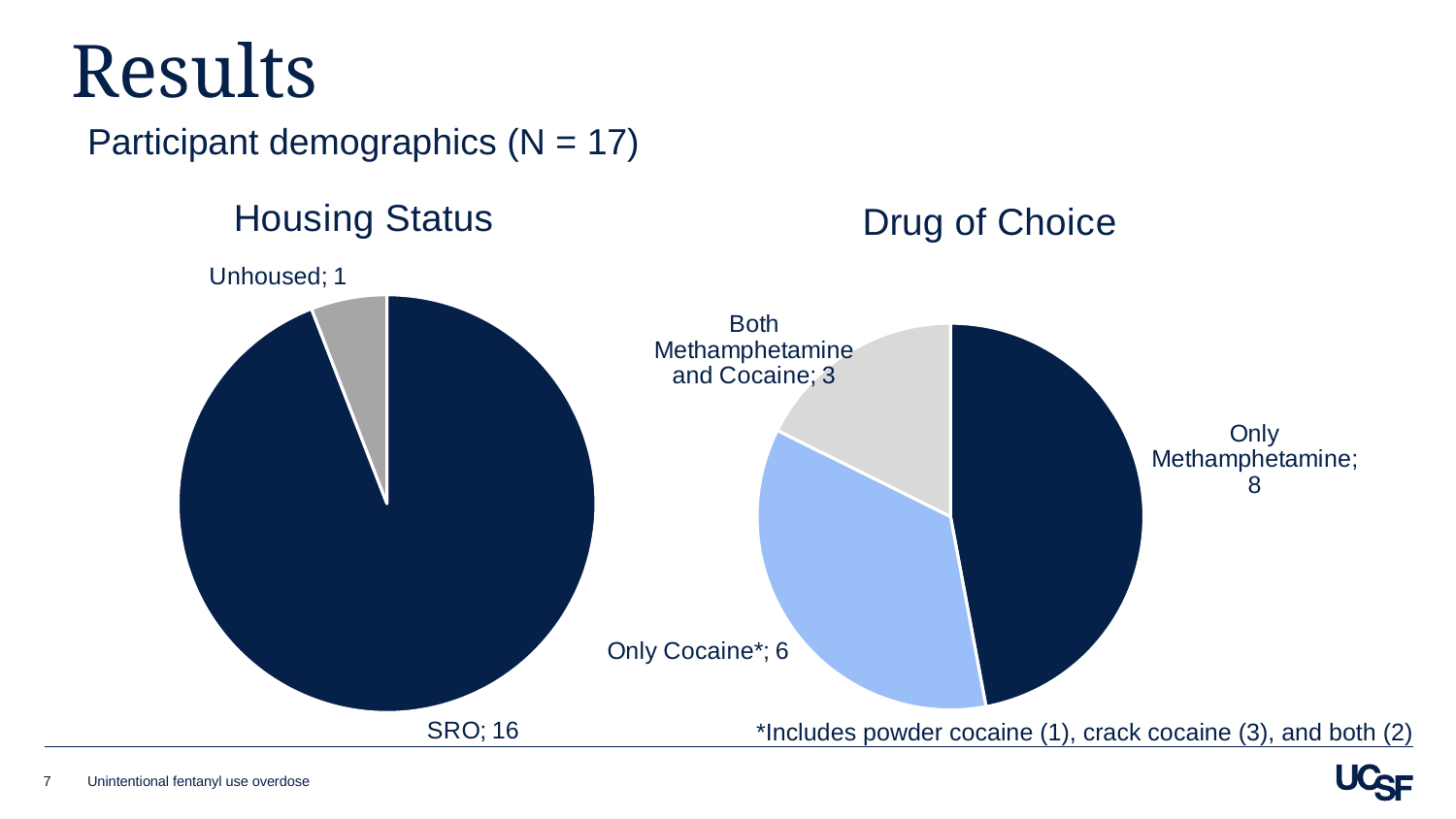
What type of chart is the Housing Status chart? Pie chart In the Drug of Choice chart, what is the difference between Only Methamphetamine and Only Cocaine*? 2 In the Drug of Choice chart, what is the value for Only Cocaine*? 6 In the Housing Status chart, what is the value for SRO? 16 In the Drug of Choice chart, which category has the highest value? Only Methamphetamine In the Drug of Choice chart, which category has the lowest value? Both Methamphetamine and Cocaine In the Drug of Choice chart, how many categories are shown? 3 In the Housing Status chart, what is the difference between SRO and Unhoused? 15 In the Drug of Choice chart, what is the value for Only Methamphetamine? 8 In the Drug of Choice chart, which is larger: Only Cocaine* or Both Methamphetamine and Cocaine? Only Cocaine* In the Housing Status chart, what is the value for Unhoused? 1 In the Drug of Choice chart, what is the value for Both Methamphetamine and Cocaine? 3